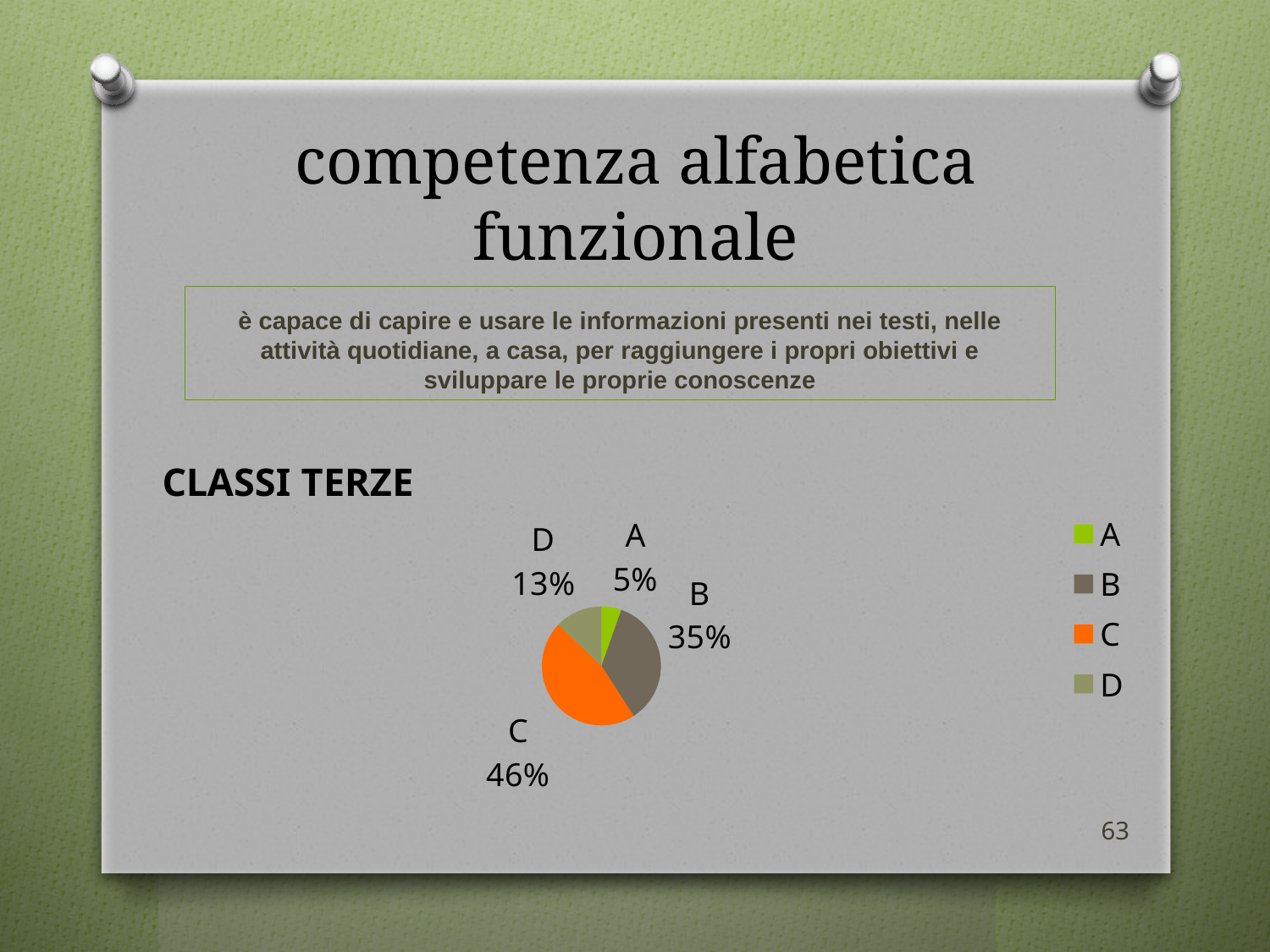
Which slice is the smallest in the pie chart? A What share of the pie does slice D represent? 13% Which slice is the largest in the pie chart? C What kind of chart is shown on the slide? pie chart What share of the pie does slice A represent? 5% What colour is slice C in the pie chart? orange What share of the pie does slice B represent? 35% How many entries does the legend list? 4 Which is larger, slice B or slice D? B What is the difference in percentage points between slices C and B? 11 How many slices does the pie chart have? 4